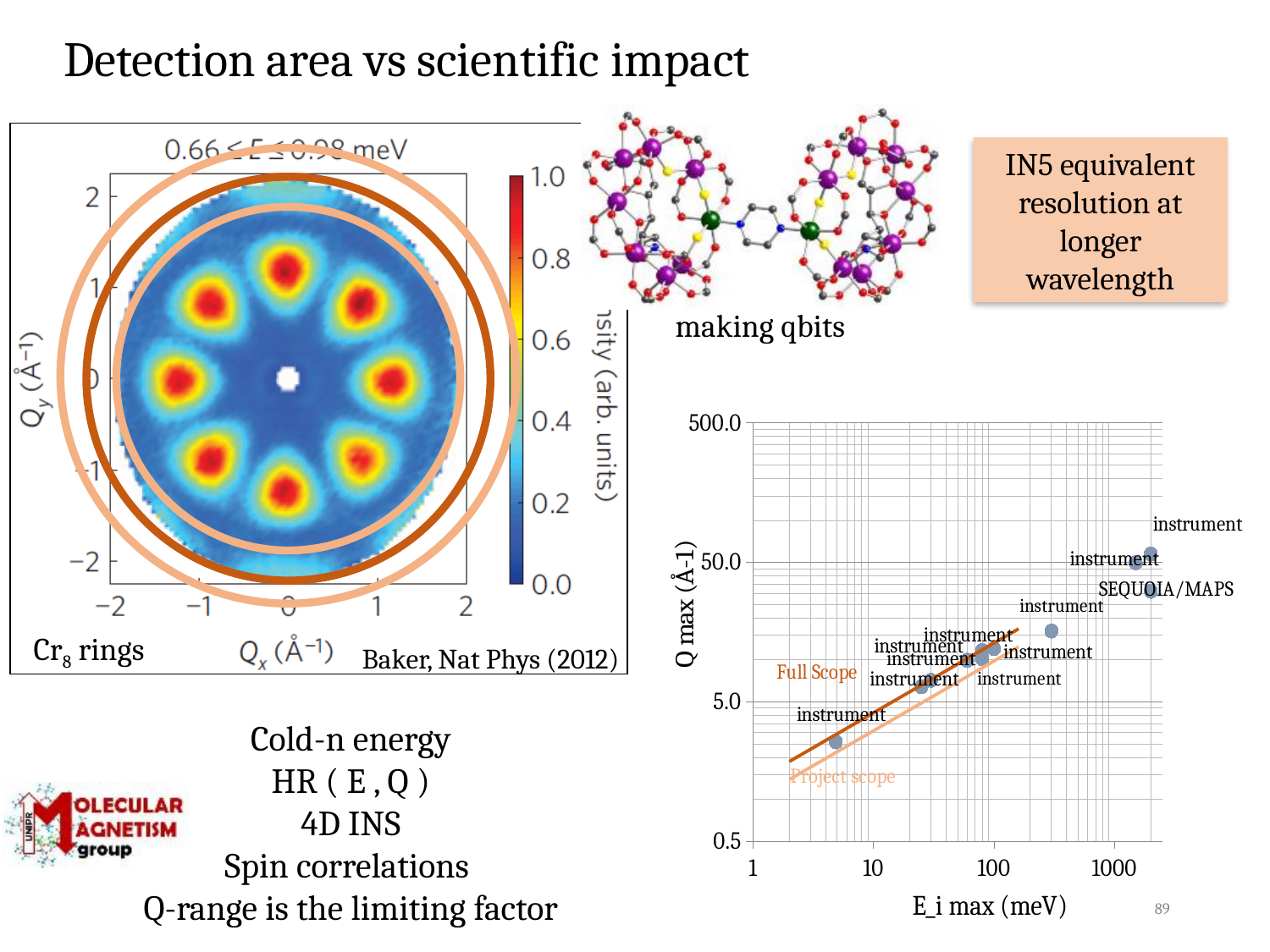
On the scatter chart at the lower right, is the Q max value for SEQUOIA/MAPS greater or less than 5.0? greater On the Cr8 rings heat map at the left, what is the maximum value shown on the colour scale? 1.0 On the scatter chart at the lower right, is the E_i max value of the lowest-left 'instrument' point greater or less than 10? less On the Cr8 rings heat map at the left, how many bright intensity spots are arranged around the centre? 8 On the scatter chart at the lower right, which of the two drawn lines lies higher, 'Full Scope' or 'Project scope'? Full Scope On the scatter chart at the lower right, what is the label of the y axis? Q max (Å-1) On the scatter chart at the lower right, is the E_i max value for SEQUOIA/MAPS greater or less than 1000? greater On the scatter chart at the lower right, what is the highest tick value shown on the y axis? 500.0 On the scatter chart at the lower right, does Q max rise or fall as E_i max increases? rise What kind of chart is the plot of Q max against E_i max at the lower right? scatter chart On the scatter chart at the lower right, what is the label of the x axis? E_i max (meV)